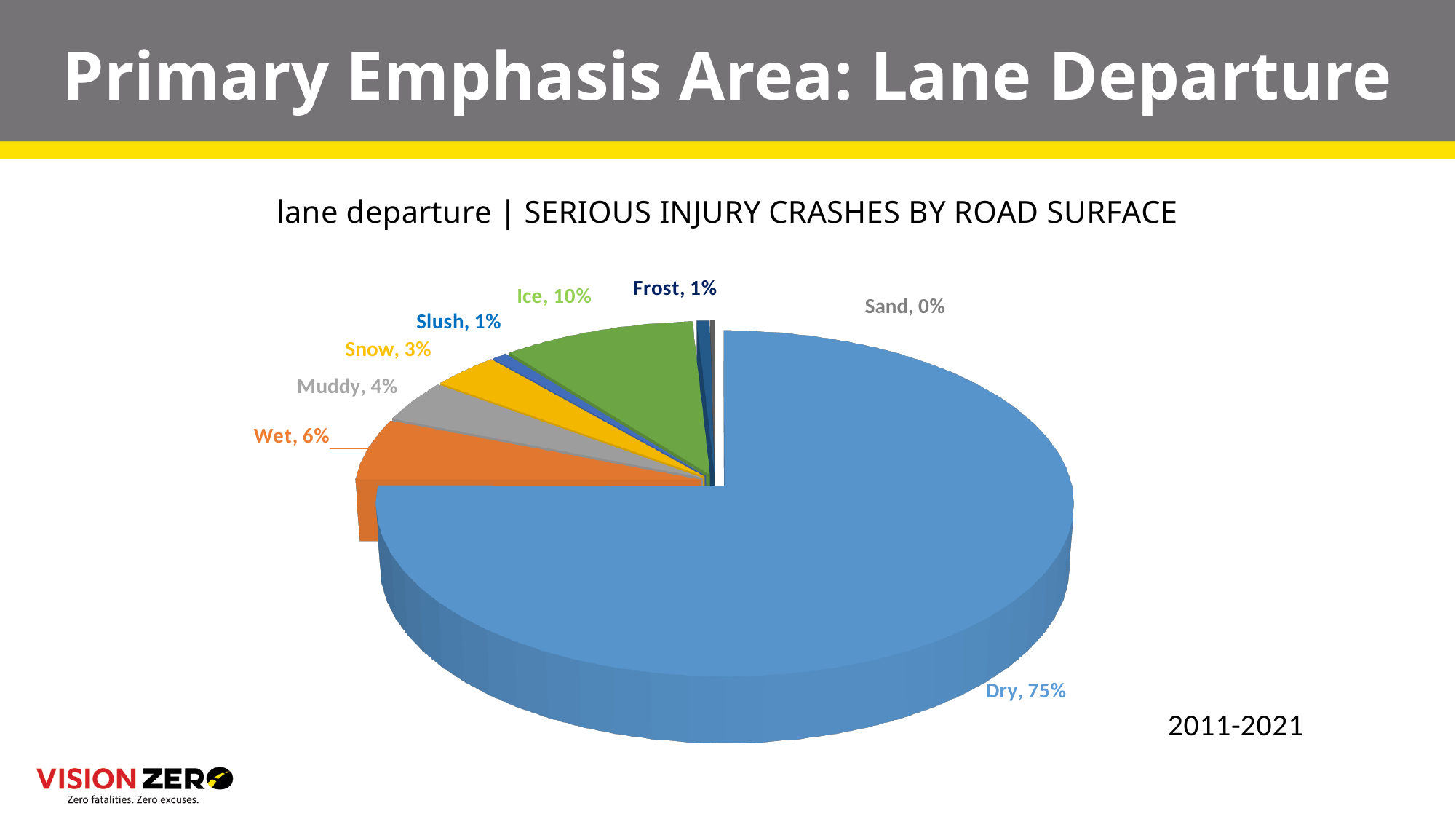
What is the difference in percentage points between the Dry and Ice slices? 65 What is the value shown for the Wet road surface? 6% What kind of chart is used on this slide? Pie chart Which has a larger share, Wet or Snow? Wet Which road surface has the smallest labelled share? Sand What time period does the chart cover? 2011-2021 What percentage is shown for Muddy road surfaces? 4% What share of lane departure serious injury crashes occurred on a dry road surface? 75% How many road surface categories are shown in the pie chart? 8 What percentage of serious injury crashes is labelled for the Ice slice? 10% What is the combined share of the Wet and Muddy slices? 10% Which road surface accounts for the largest share of serious injury crashes? Dry